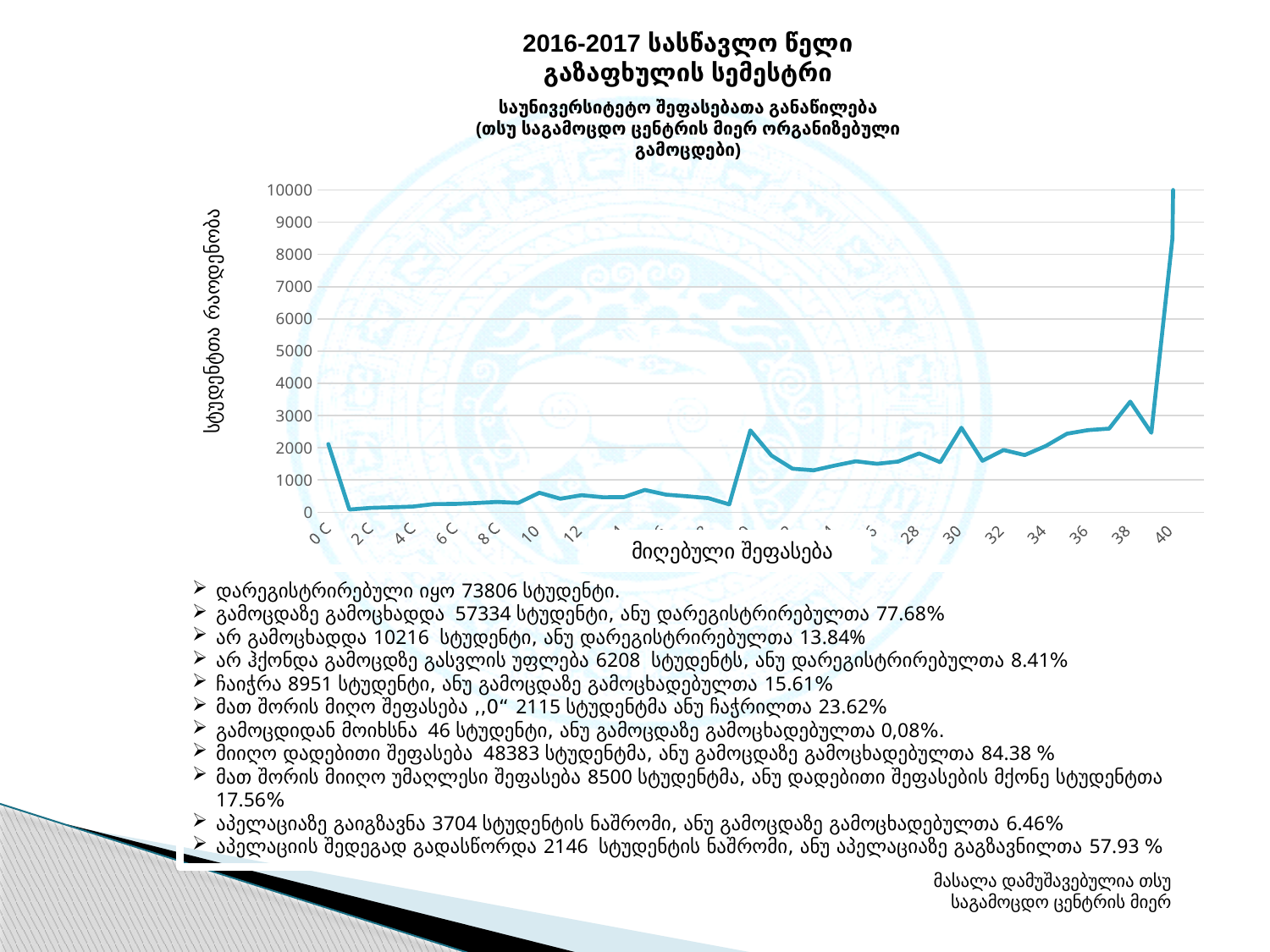
What kind of chart is shown on the slide? line chart Is the number of students for score 0 greater or less than 1000? greater Which score on the x axis has the highest number of students? 40 Is the number of students for score 20 greater or less than 2000? greater Is the number of students for score 38 greater or less than 3000? greater Which has more students, score 40 or score 38? score 40 What is the title of the y axis of the chart? სტუდენტთა რაოდენობა Does the number of students generally rise or fall along the x axis from score 20 to score 40? rise Which has more students, score 0 or score 10? score 0